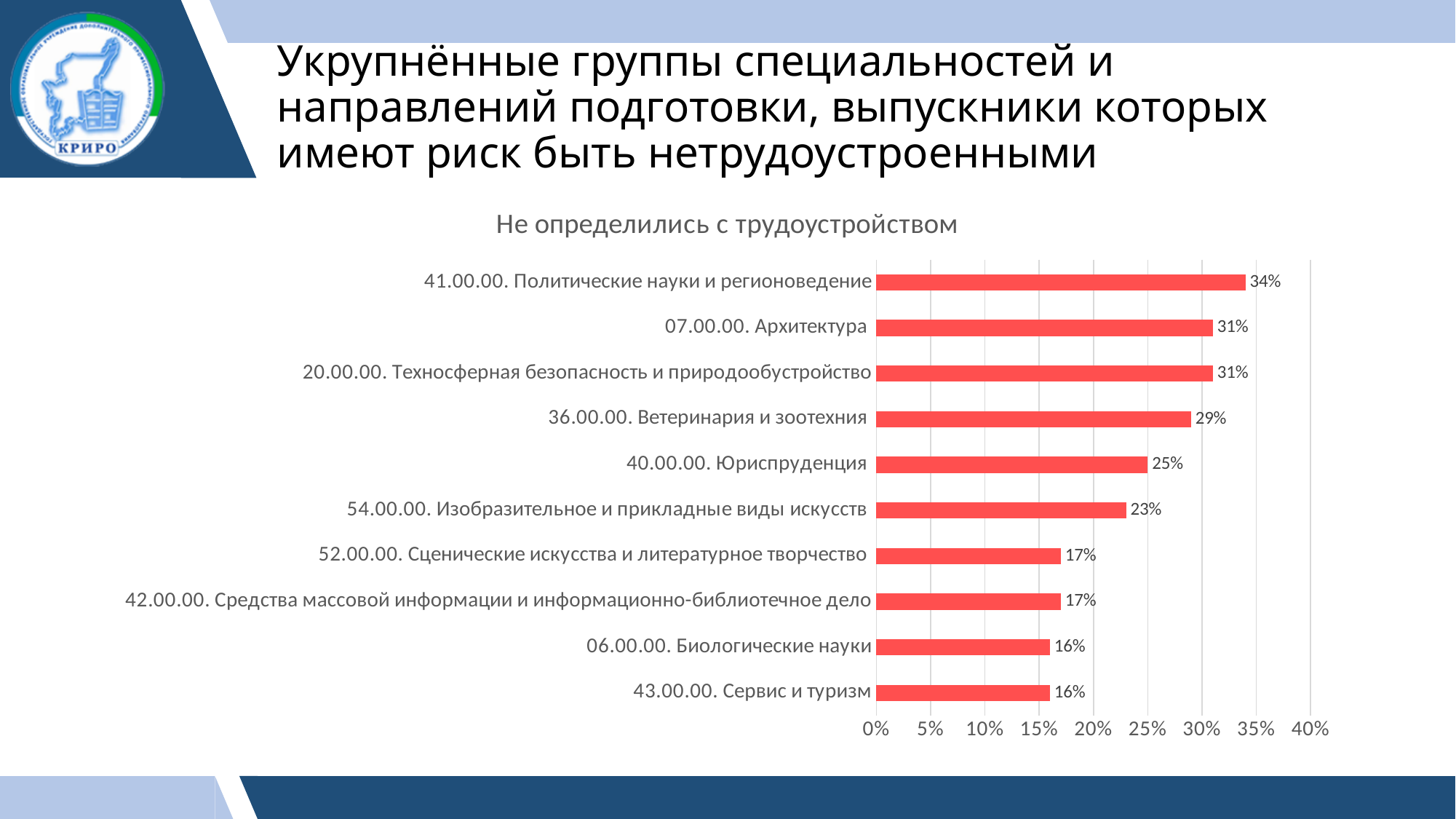
What is the title of the chart? Не определились с трудоустройством What is the value for 40.00.00. Юриспруденция? 25% Is the value for 36.00.00. Ветеринария и зоотехния greater or less than 25%? greater What is the difference between the values for 36.00.00. Ветеринария и зоотехния and 54.00.00. Изобразительное и прикладные виды искусств? 6% What is the maximum value shown on the horizontal axis? 40% Which is larger: the value for 07.00.00. Архитектура or the value for 40.00.00. Юриспруденция? 07.00.00. Архитектура How many categories are shown in the chart? 10 Which category has the highest value? 41.00.00. Политические науки и регионоведение What is the value for 41.00.00. Политические науки и регионоведение? 34% What is the value for 06.00.00. Биологические науки? 16% What is the difference between the values for 41.00.00. Политические науки и регионоведение and 43.00.00. Сервис и туризм? 18% What kind of chart is shown on the slide? bar chart